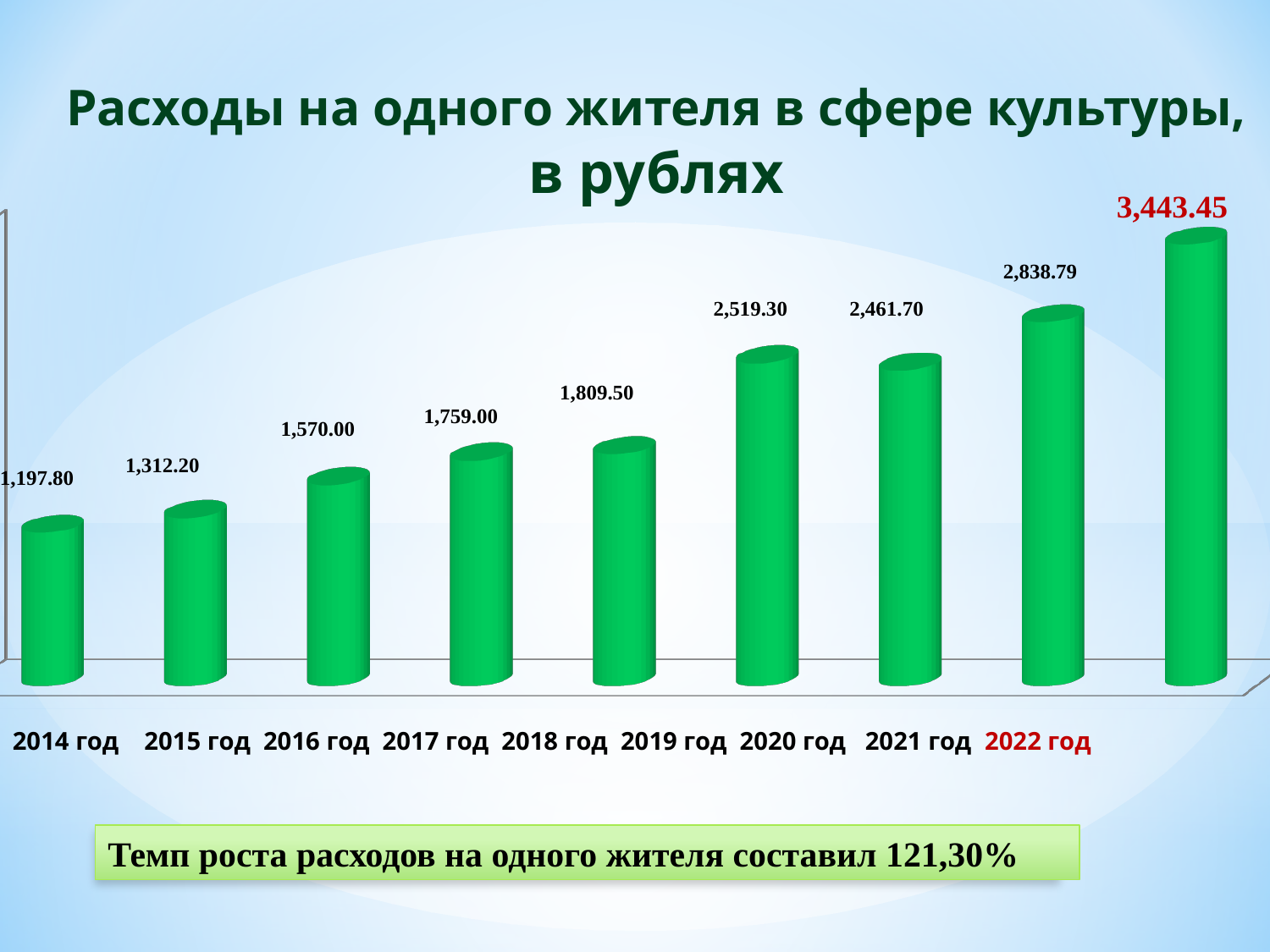
What is the value for 2019 год? 2,519.30 Which year has the lowest value? 2014 год Which year has the highest value? 2022 год What is the difference between the values for 2019 год and 2020 год? 57.60 What is the difference between the values for 2022 год and 2021 год? 604.66 Which is larger, the value for 2019 год or the value for 2020 год? 2019 год What is the value for 2017 год? 1,759.00 What kind of chart is shown on the slide? Bar chart How many years are shown on the chart? 9 What is the title of the chart? Расходы на одного жителя в сфере культуры, в рублях What is the value for 2022 год? 3,443.45 What is the value for 2014 год? 1,197.80